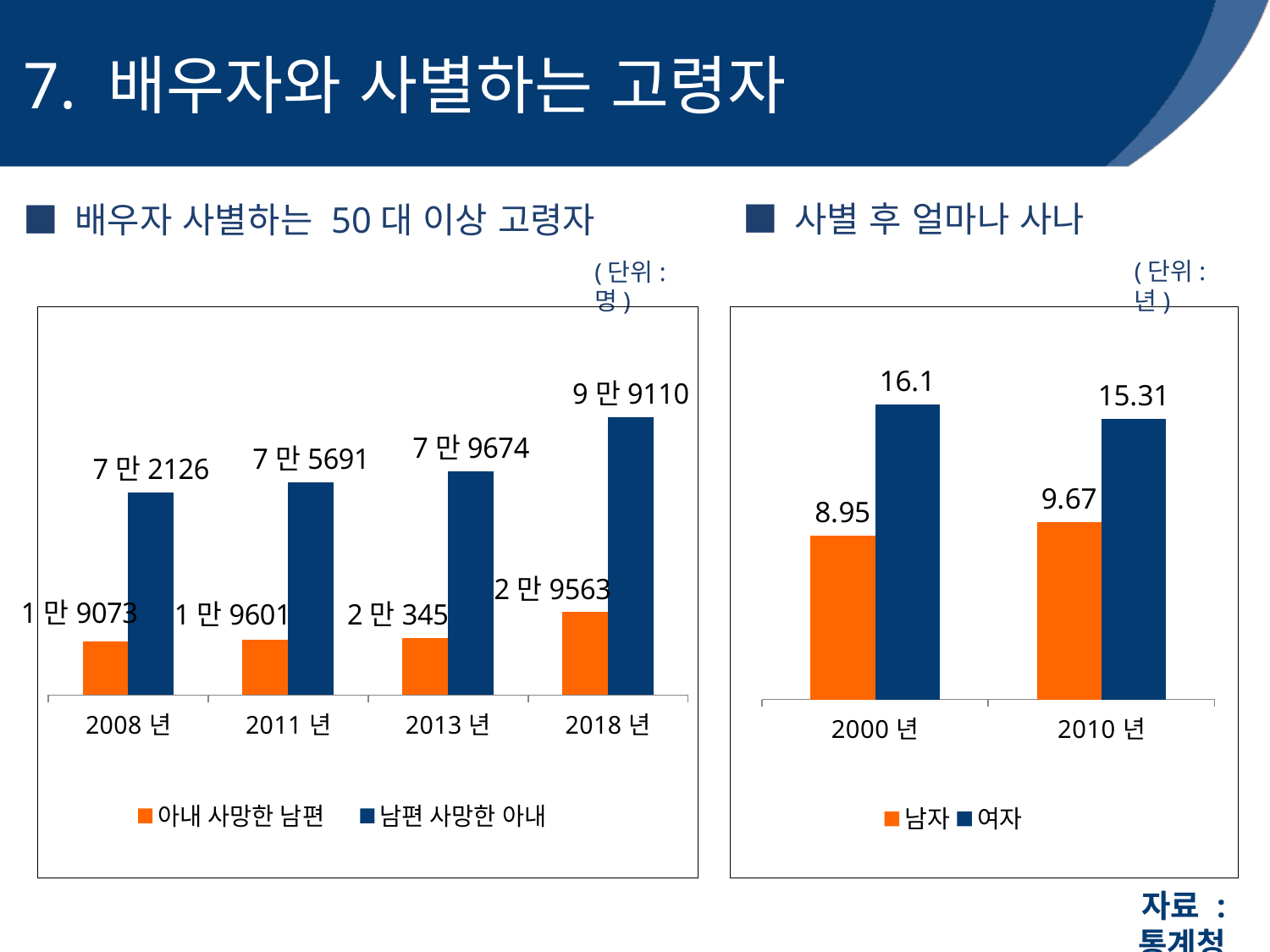
In the right chart (사별 후 얼마나 사나), what is the value for 여자 in 2000년? 16.1 In the right chart (사별 후 얼마나 사나), how many series does the legend list? 2 In the right chart (사별 후 얼마나 사나), what is the value for 남자 in 2010년? 9.67 In the left chart (배우자 사별하는 50대 이상 고령자), which year has the highest value for 남편 사망한 아내? 2018 년 In the left chart (배우자 사별하는 50대 이상 고령자), which year has the lowest value for 아내 사망한 남편? 2008 년 In the left chart (배우자 사별하는 50대 이상 고령자), what is the difference between 남편 사망한 아내 in 2018년 and in 2008년? 2 만 6984 In the right chart (사별 후 얼마나 사나), what is the difference between 여자 and 남자 in 2000년? 7.15 In the left chart (배우자 사별하는 50대 이상 고령자), how many years are shown on the x axis? 4 In the left chart (배우자 사별하는 50대 이상 고령자), what is the value for 남편 사망한 아내 in 2018년? 9 만 9110 In the left chart (배우자 사별하는 50대 이상 고령자), does the value for 남편 사망한 아내 rise or fall from 2008년 to 2018년? rise In the left chart (배우자 사별하는 50대 이상 고령자), what is the value for 아내 사망한 남편 in 2013년? 2 만 345 In the right chart (사별 후 얼마나 사나), which is larger in 2010년, 남자 or 여자? 여자